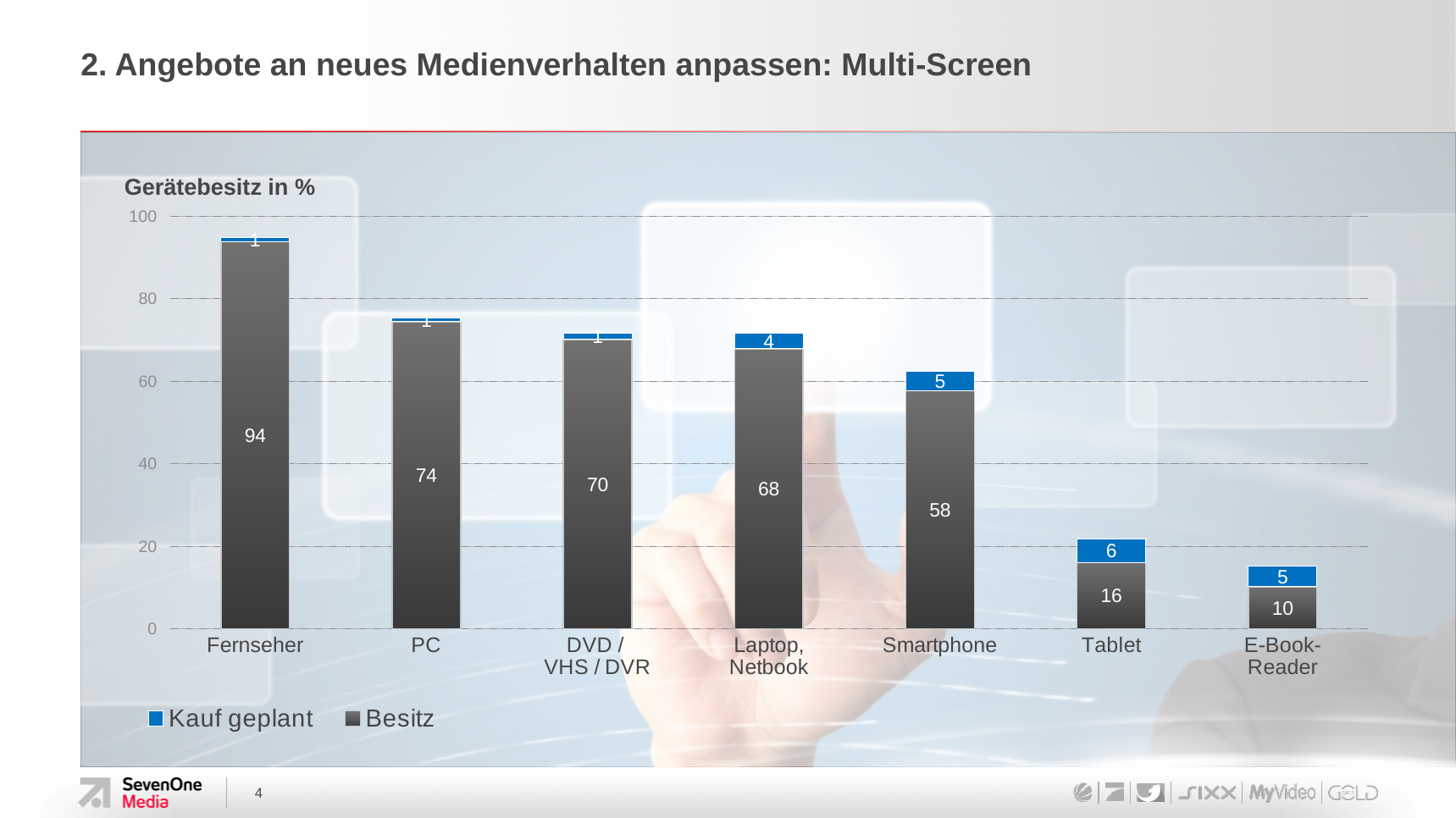
What kind of chart is shown on the slide? Stacked bar chart What is the total of the stacked bar for Tablet? 22 What is the Besitz value for Smartphone? 58 Which has a larger Besitz value, DVD / VHS / DVR or Smartphone? DVD / VHS / DVR How many series does the legend list? 2 What is the title of the chart? Gerätebesitz in % What is the Besitz value for E-Book-Reader? 10 How many categories are shown on the x axis? 7 Which category has the lowest Besitz value? E-Book-Reader Which category has the highest Besitz value? Fernseher What is the difference between the Besitz values for PC and Laptop, Netbook? 6 What is the Kauf geplant value for Tablet? 6